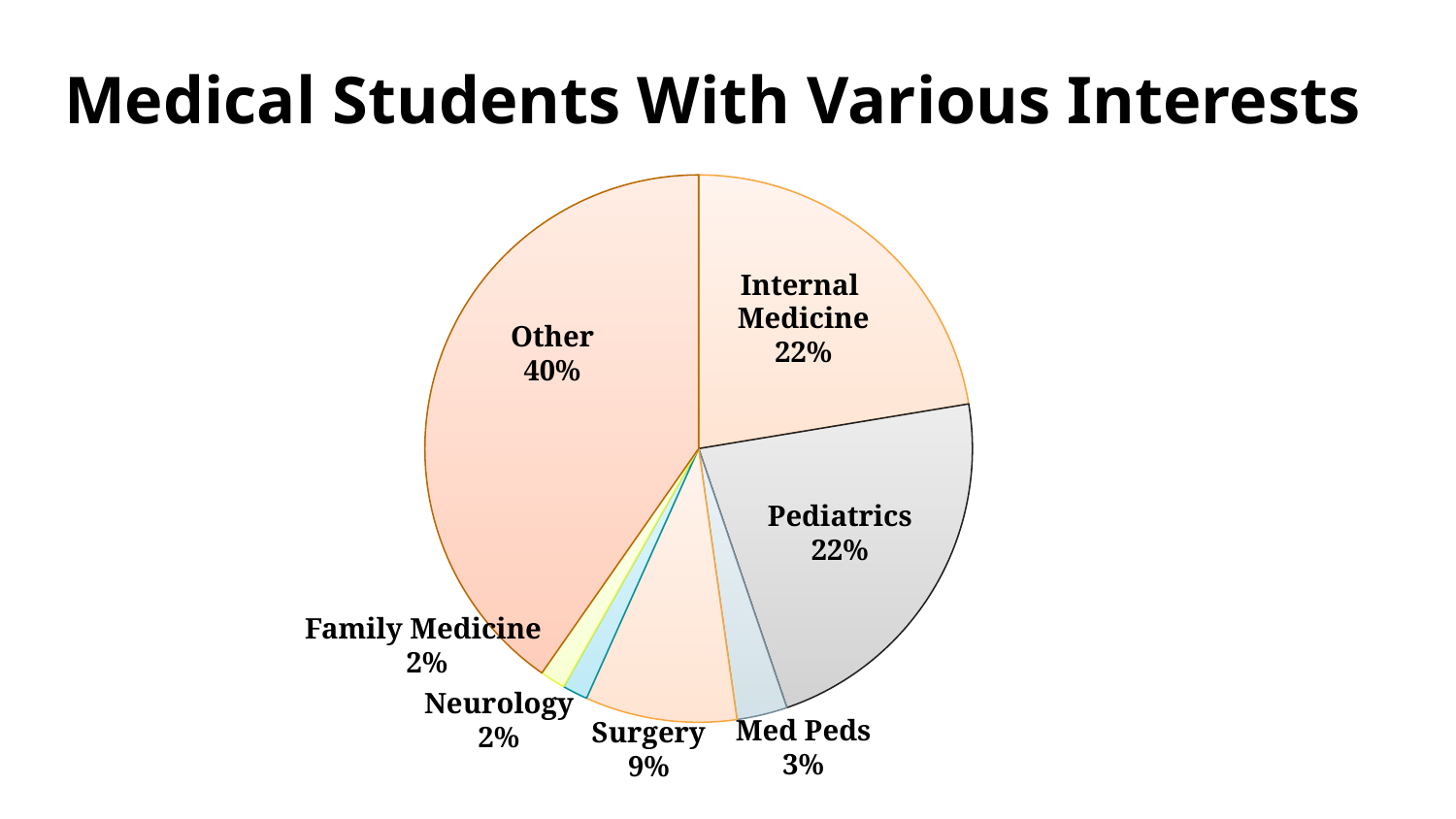
What share of the pie is Other? 40% What is the title of the chart? Medical Students With Various Interests What is the difference between the Other share and the Pediatrics share? 18% What kind of chart is shown on the slide? pie chart Which is larger, Surgery or Med Peds? Surgery What is the combined share of Internal Medicine and Pediatrics? 44% How many slices does the pie chart have? 7 Which category has the largest slice of the pie? Other What is the difference between the Surgery share and the Neurology share? 7% What percentage is shown for Internal Medicine? 22% What percentage is shown for Surgery? 9% What percentage is shown for Med Peds? 3%